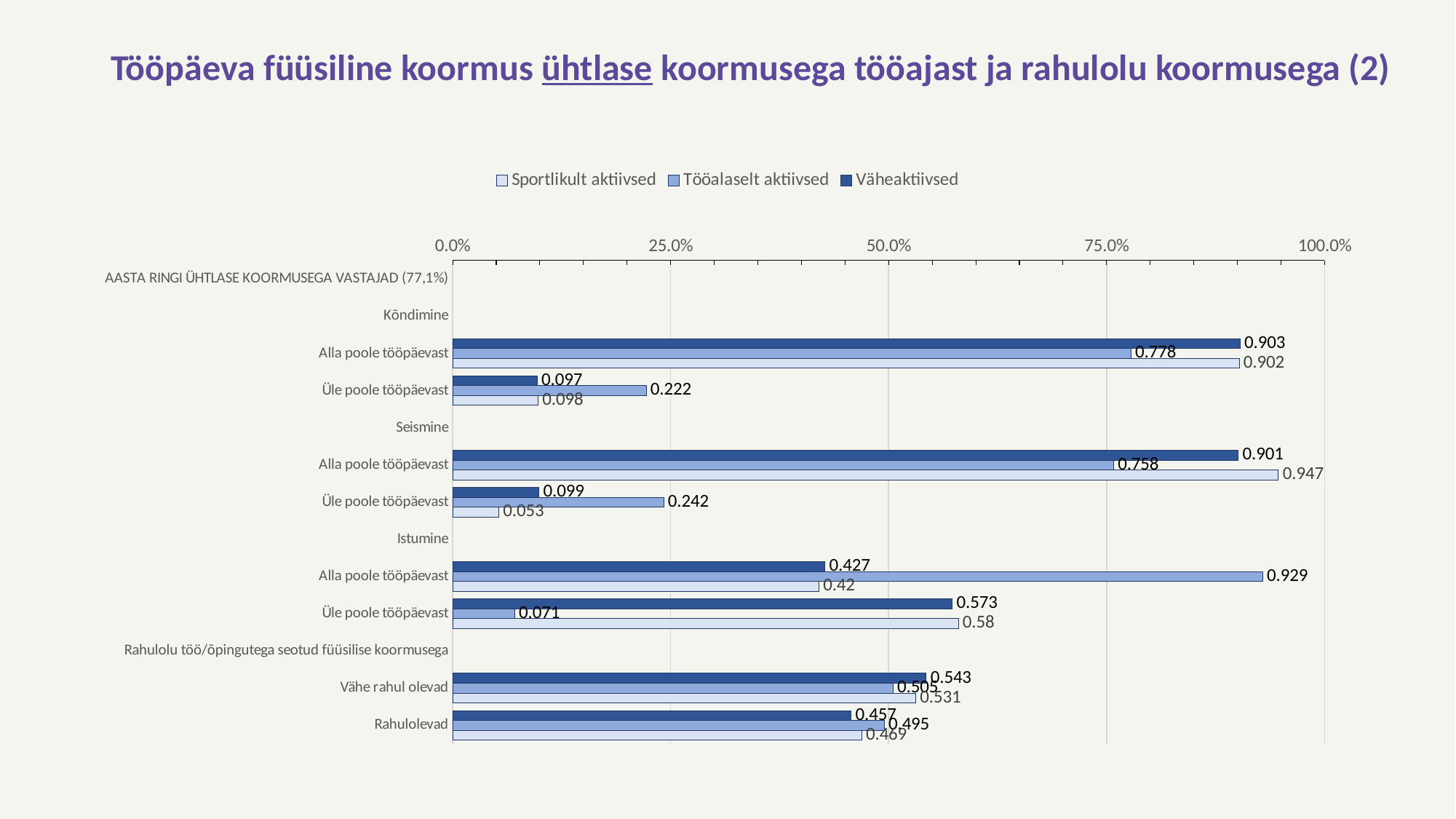
Is the Väheaktiivsed value for 'Alla poole tööpäevast' under Istumine greater or less than 50.0%? less What is the value for Väheaktiivsed for 'Alla poole tööpäevast' under Kõndimine? 0.903 What is the value for Sportlikult aktiivsed for 'Alla poole tööpäevast' under Seismine? 0.947 What is the value for Tööalaselt aktiivsed for 'Üle poole tööpäevast' under Seismine? 0.242 What is the difference between the Sportlikult aktiivsed and Tööalaselt aktiivsed values for 'Üle poole tööpäevast' under Istumine? 0.509 Which legend entry is shown with the darkest blue colour? Väheaktiivsed Which series has the highest value for 'Üle poole tööpäevast' under Kõndimine? Tööalaselt aktiivsed Which series has the lowest value for 'Üle poole tööpäevast' under Istumine? Tööalaselt aktiivsed How many series does the legend list? 3 What is the value for Tööalaselt aktiivsed for 'Alla poole tööpäevast' under Istumine? 0.929 For 'Rahulolevad', which is larger: the Tööalaselt aktiivsed value or the Väheaktiivsed value? Tööalaselt aktiivsed What kind of chart is shown on the slide? bar chart